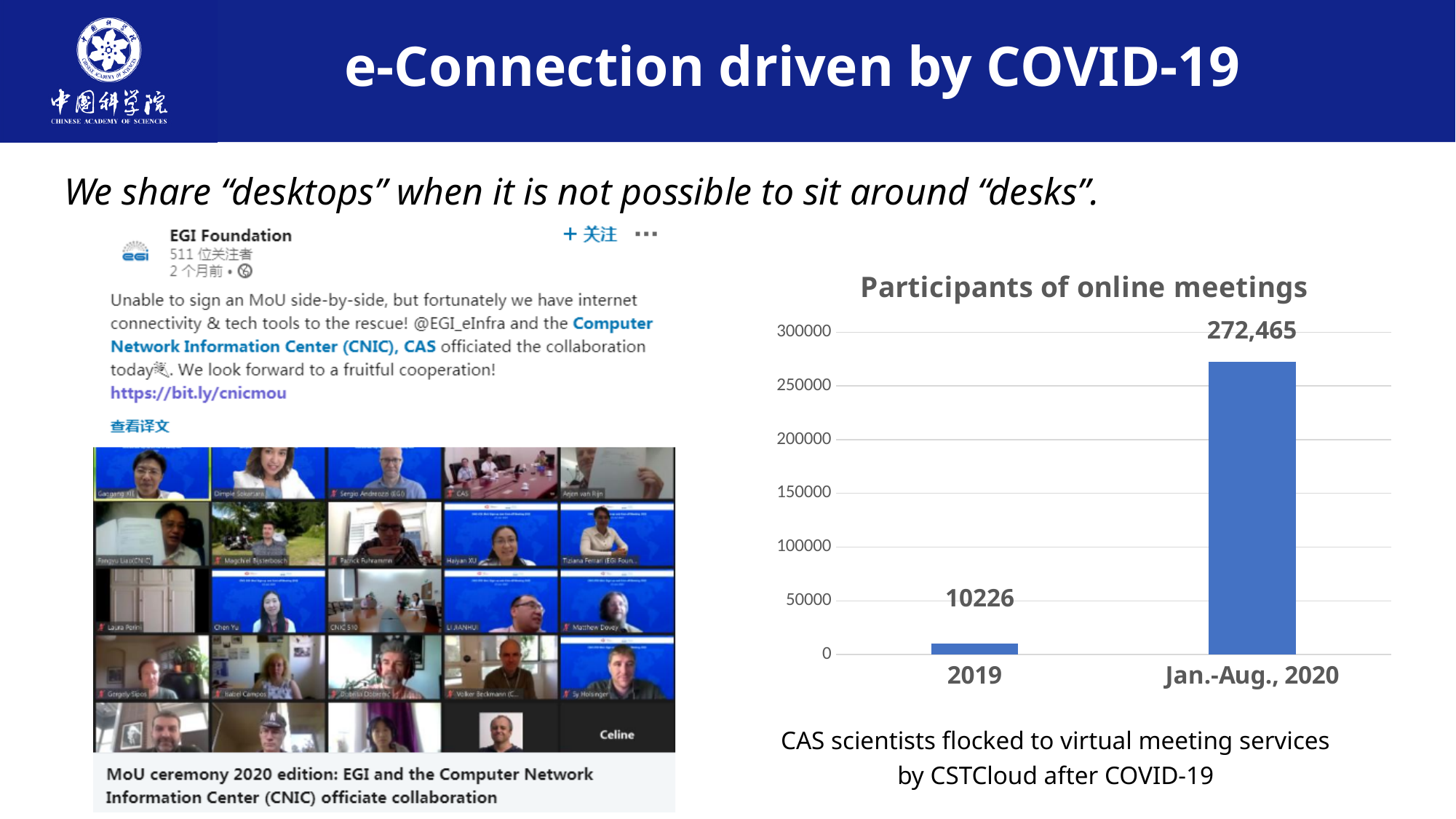
What is the title of the chart on the slide? Participants of online meetings What is the difference between the Jan.-Aug., 2020 value and the 2019 value in the Participants of online meetings chart? 262,239 Is the value for Jan.-Aug., 2020 greater or less than 250000? greater Which is larger in the Participants of online meetings chart: the value for 2019 or the value for Jan.-Aug., 2020? Jan.-Aug., 2020 Which category has the lowest value in the Participants of online meetings chart? 2019 Which category has the highest value in the Participants of online meetings chart? Jan.-Aug., 2020 Is the value for 2019 greater or less than 50000? less What is the value for Jan.-Aug., 2020 in the Participants of online meetings chart? 272,465 Do the values rise or fall from 2019 to Jan.-Aug., 2020 in the chart? rise What is the value for 2019 in the Participants of online meetings chart? 10226 What kind of chart is the Participants of online meetings chart? bar chart How many categories are shown in the Participants of online meetings chart? 2